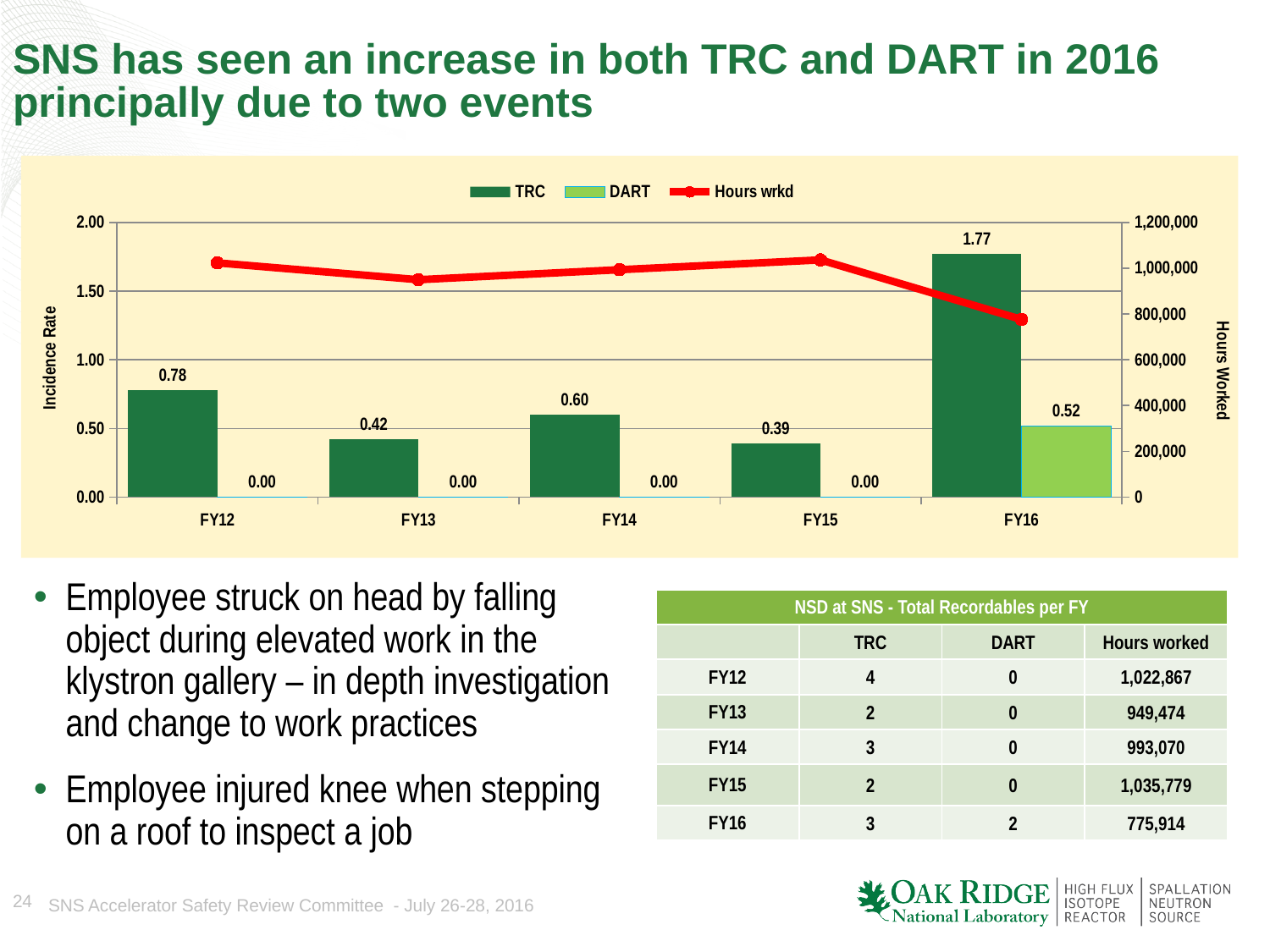
What is the difference between the TRC incidence rate in FY16 and FY15? 1.38 Which is larger, the TRC incidence rate for FY12 or for FY14? FY12 Which fiscal year has the lowest TRC incidence rate? FY15 How many series does the chart legend list? 3 Which fiscal year has the highest TRC incidence rate? FY16 Is the Hours wrkd value for FY16 greater or less than 800,000? less What is the TRC incidence rate for FY13? 0.42 How many fiscal years are shown on the x axis of the chart? 5 What is the DART incidence rate for FY16? 0.52 What is the DART incidence rate for FY14? 0.00 What is the TRC incidence rate for FY16? 1.77 Is the Hours wrkd value for FY15 greater or less than 1,000,000? greater